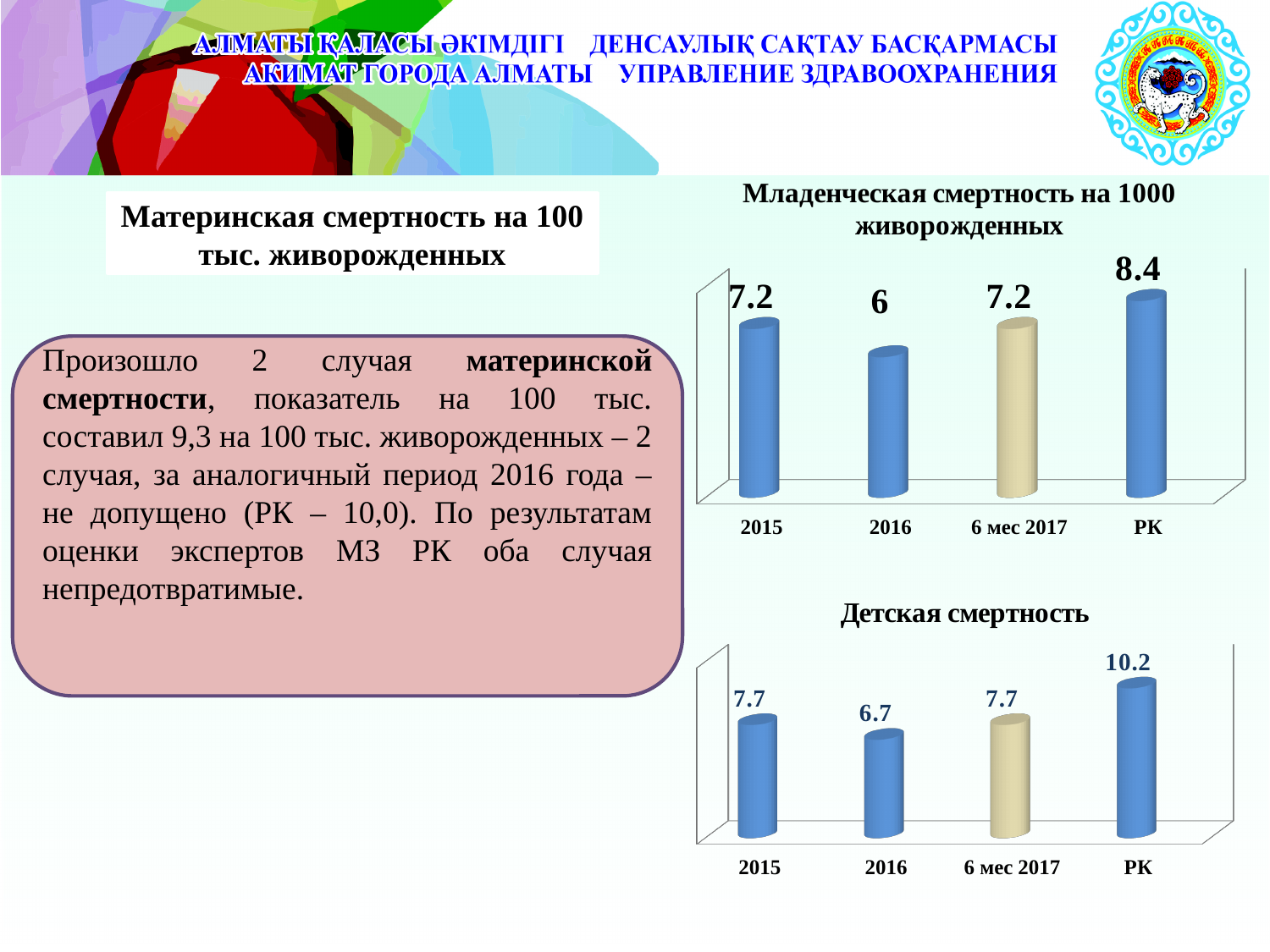
In the chart titled "Младенческая смертность на 1000 живорожденных", which category has the lowest value? 2016 What kind of chart is the chart titled "Детская смертность"? Bar chart In the chart titled "Младенческая смертность на 1000 живорожденных", how many bars are plotted? 4 In the chart titled "Детская смертность", what is the value for 6 мес 2017? 7.7 In the chart titled "Детская смертность", which is larger: the value for 2015 or the value for 2016? 2015 In the chart titled "Младенческая смертность на 1000 живорожденных", what is the value for РК? 8.4 In the chart titled "Младенческая смертность на 1000 живорожденных", which bar is coloured differently (beige) from the others? 6 мес 2017 In the chart titled "Младенческая смертность на 1000 живорожденных", what is the value for 2016? 6 In the chart titled "Детская смертность", which category has the highest value? РК In the chart titled "Детская смертность", what is the value for 2016? 6.7 In the chart titled "Детская смертность", what is the difference between the РК value and the 2015 value? 2.5 In the chart titled "Младенческая смертность на 1000 живорожденных", what is the difference between the РК value and the 2016 value? 2.4